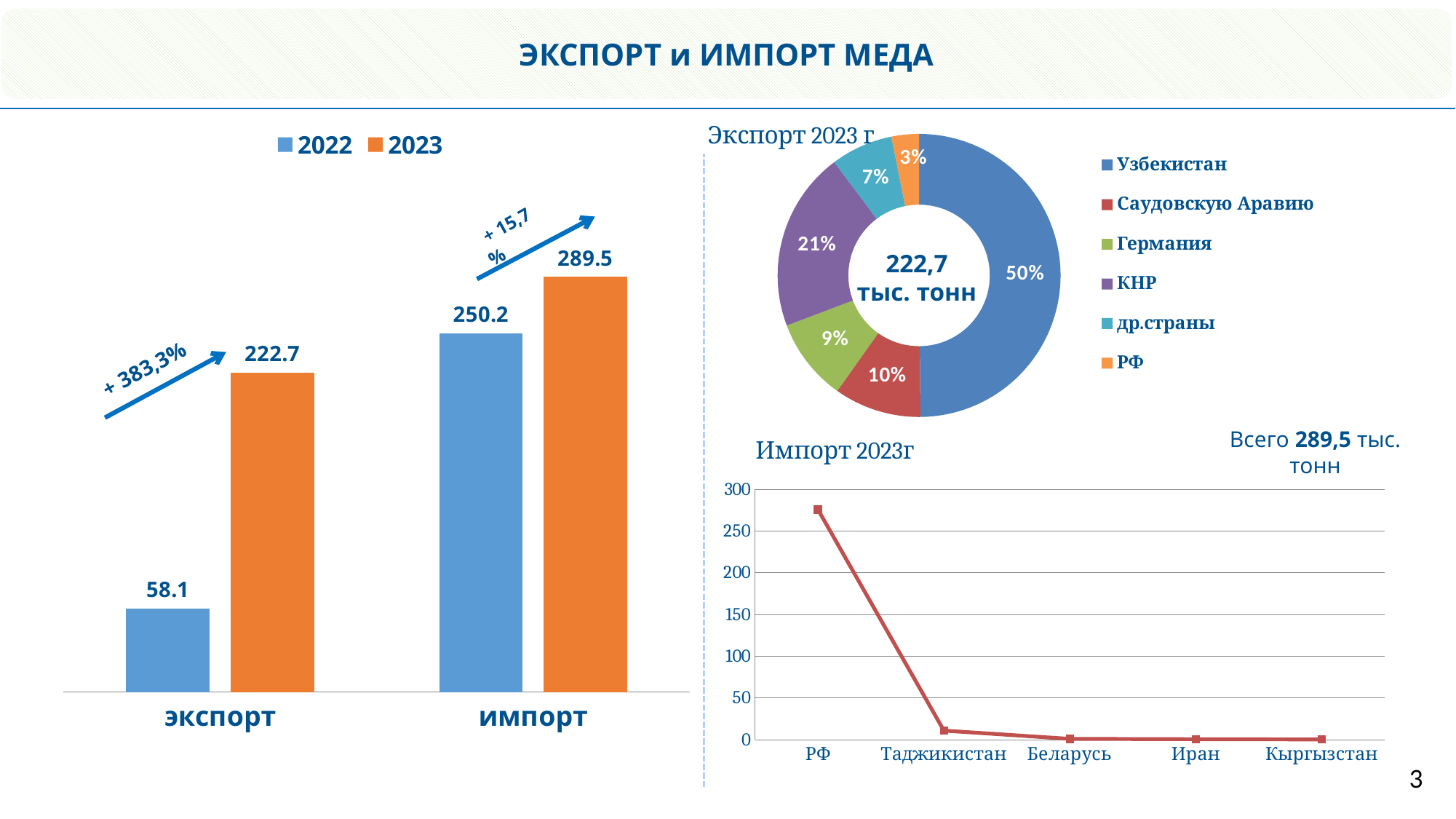
What kind of chart is the chart on the left of the slide? bar chart How many series does the legend of the bar chart on the left list? 2 How many slices does the 'Экспорт 2023 г' chart have? 6 In the 'Импорт 2023г' line chart, do the values rise or fall from РФ to Кыргызстан? fall In the bar chart on the left, which is larger: экспорт in 2022 or импорт in 2022? импорт in 2022 In the bar chart on the left, what is the difference between the 2023 and 2022 values for импорт? 39.3 In the bar chart on the left, what is the value for экспорт in 2023? 222.7 In the 'Экспорт 2023 г' chart, which country has the largest share? Узбекистан In the 'Экспорт 2023 г' chart, what share does КНР have? 21% In the 'Импорт 2023г' line chart, is the value for РФ greater or less than 250? greater In the bar chart on the left, what is the value for импорт in 2022? 250.2 In the 'Экспорт 2023 г' chart, which category has the smallest share? РФ